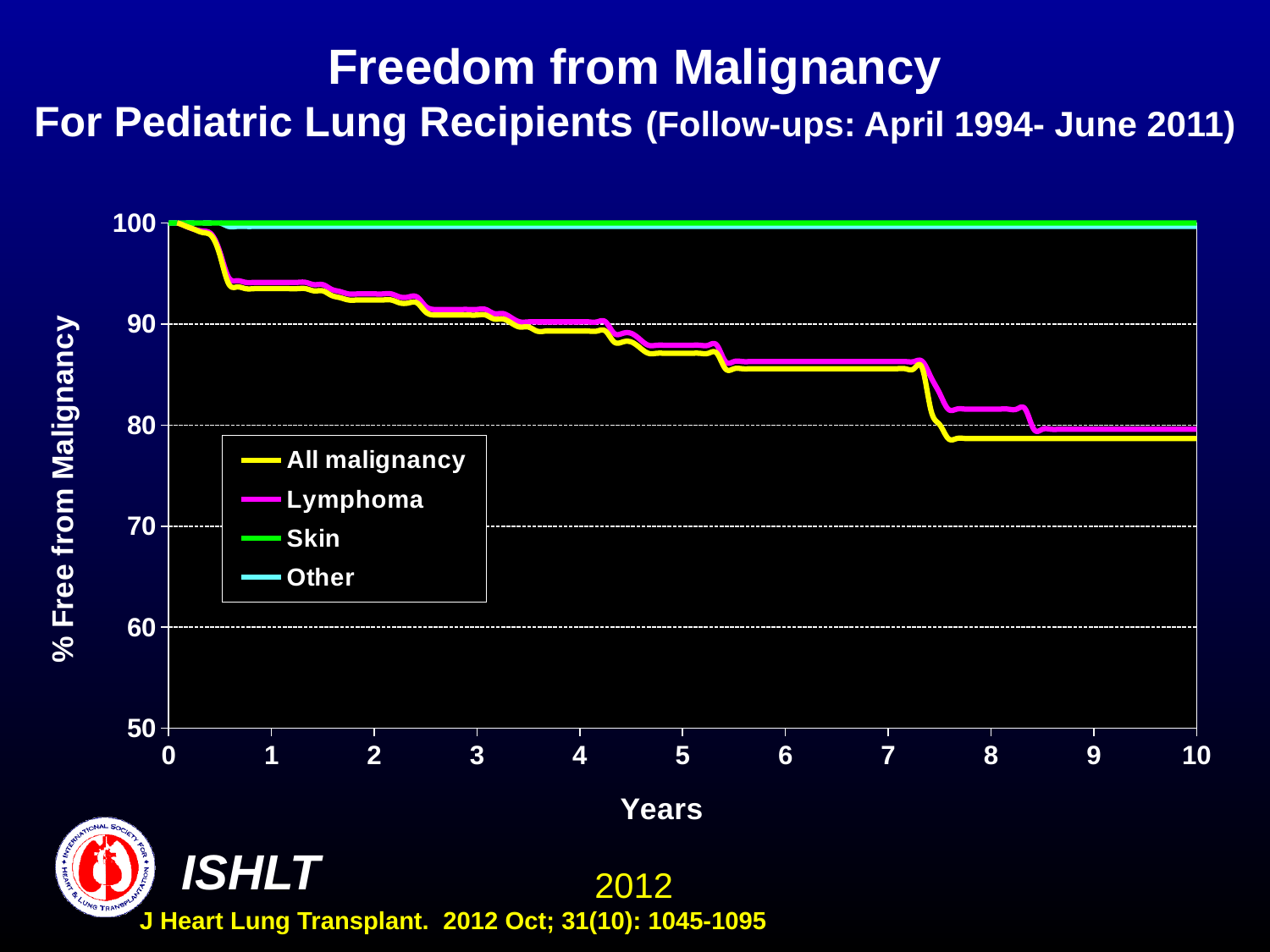
How many series does the legend list? 4 What is the label of the y axis? % Free from Malignancy Is the value for Skin at year 10 greater or less than 90? greater Is the value for All malignancy at year 10 greater or less than 80? less At year 10, which series has the higher value, Skin or All malignancy? Skin Is the value for Lymphoma at year 5 greater or less than 80? greater Does the All malignancy line rise or fall as the years increase? fall Does the Lymphoma line rise or fall from year 0 to year 10? fall What kind of chart is shown on the slide? line chart Which series are listed in the legend? All malignancy, Lymphoma, Skin, Other At year 8, which series has the higher value, Lymphoma or All malignancy? Lymphoma